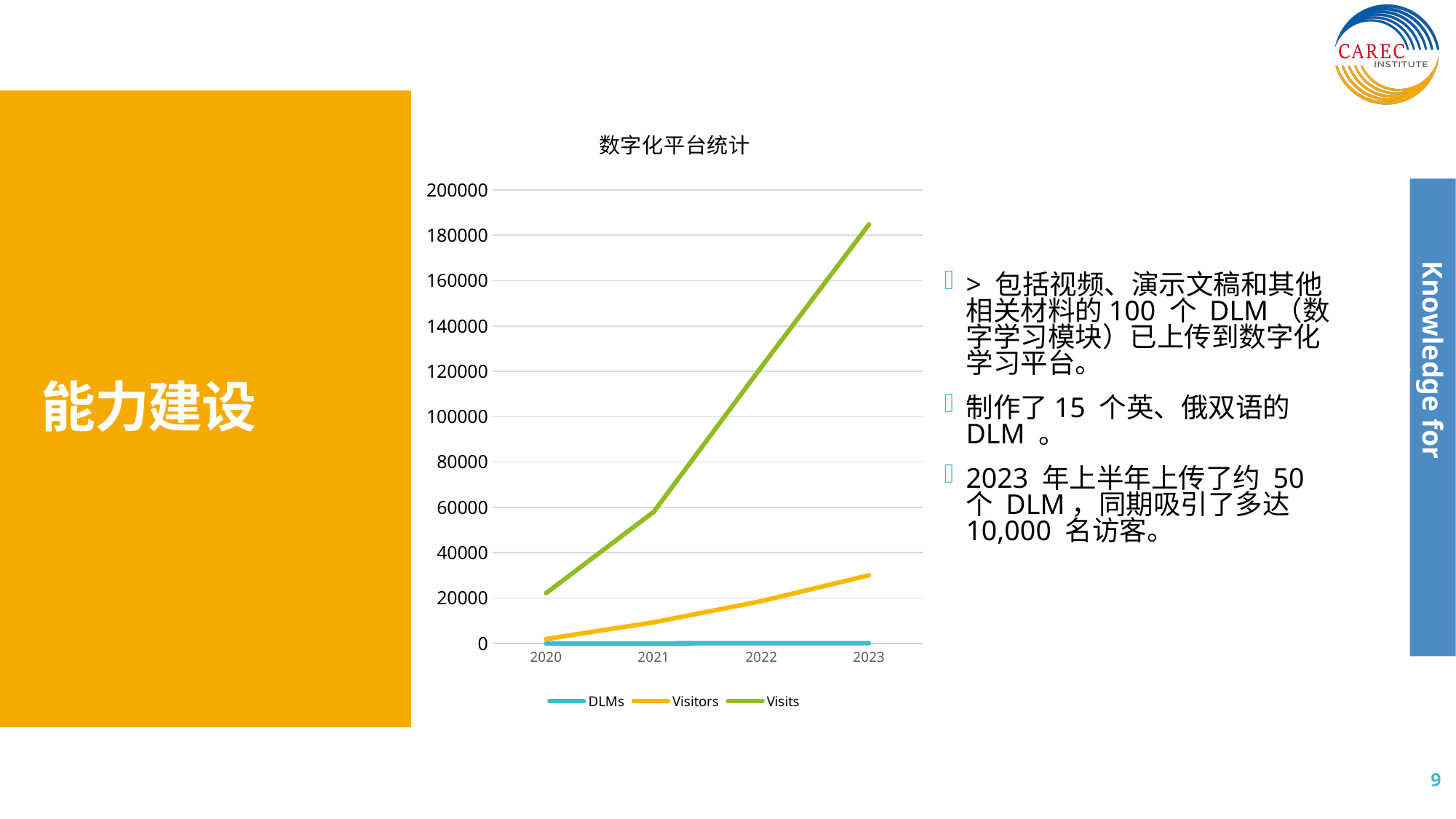
Is the value for Visitors in 2023 greater or less than 20000? greater Which series has the lowest values across all years? DLMs In 2022, which is larger: Visits or Visitors? Visits How many series does the chart legend list? 3 Is the value for Visits in 2021 greater or less than 80000? less Is the value for Visits in 2023 greater or less than 160000? greater How many years are shown on the x axis of the chart? 4 What kind of chart is shown on the slide? line chart Which series has the highest value in 2023? Visits Do the values for Visits rise or fall from 2020 to 2023? rise What is the title of the chart? 数字化平台统计 Which colour is used for the Visits line in the chart? green